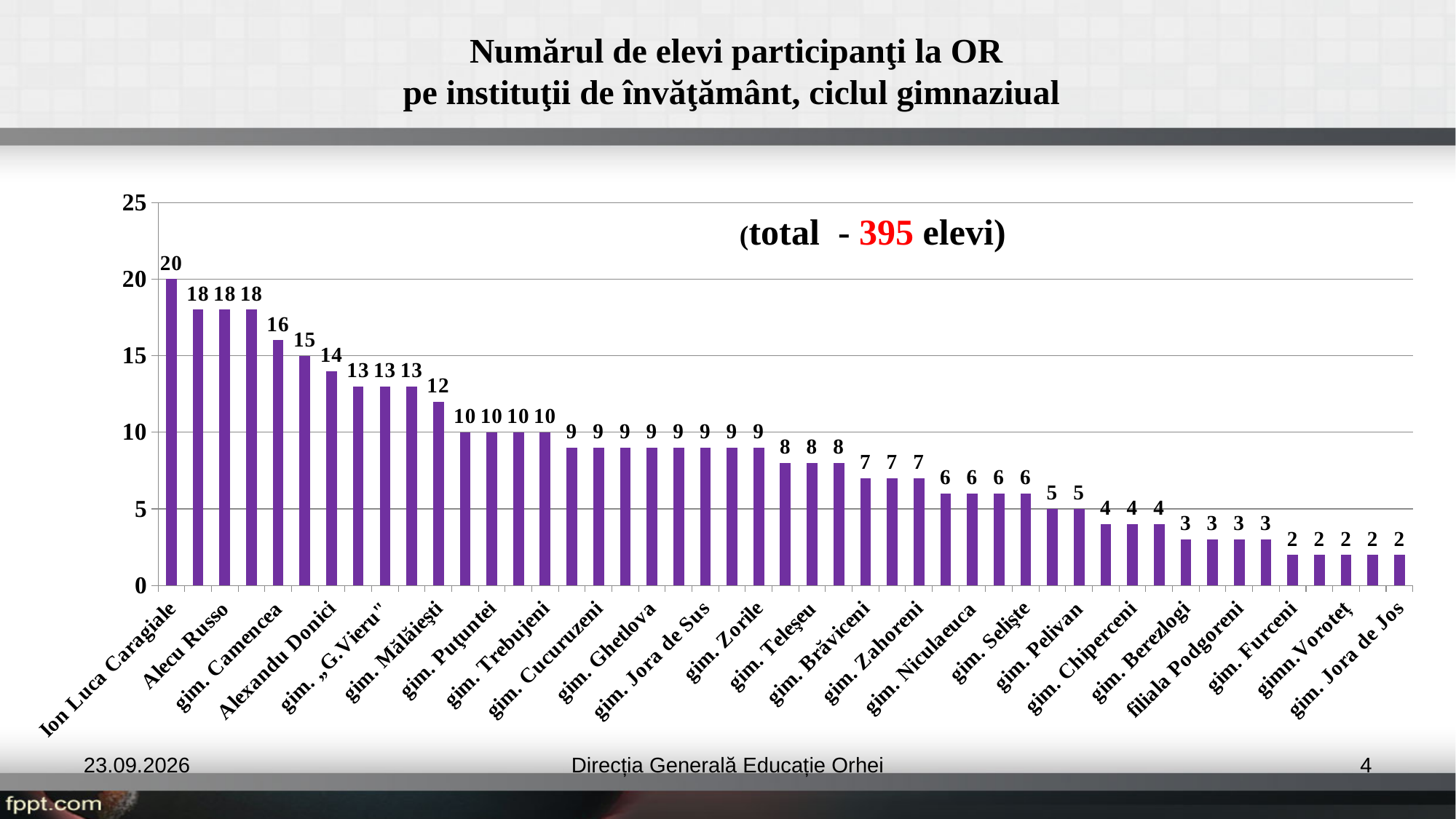
What type of chart is shown on the slide? bar chart Which institution has the highest number of participating pupils? Ion Luca Caragiale How many pupils from Ion Luca Caragiale participated? 20 Which has a larger value, Ion Luca Caragiale or gim. Jora de Jos? Ion Luca Caragiale What is the difference between the values for Ion Luca Caragiale and gim. Jora de Jos? 18 How many pupils from gim. Jora de Jos participated? 2 What total number of pupils is stated on the chart? 395 elevi What is the highest value shown on the chart? 20 Is the value for Ion Luca Caragiale greater or less than 15? greater How many bars show a value of 9? 8 Do the values rise or fall from left to right along the x axis? fall What is the lowest value shown on the chart? 2